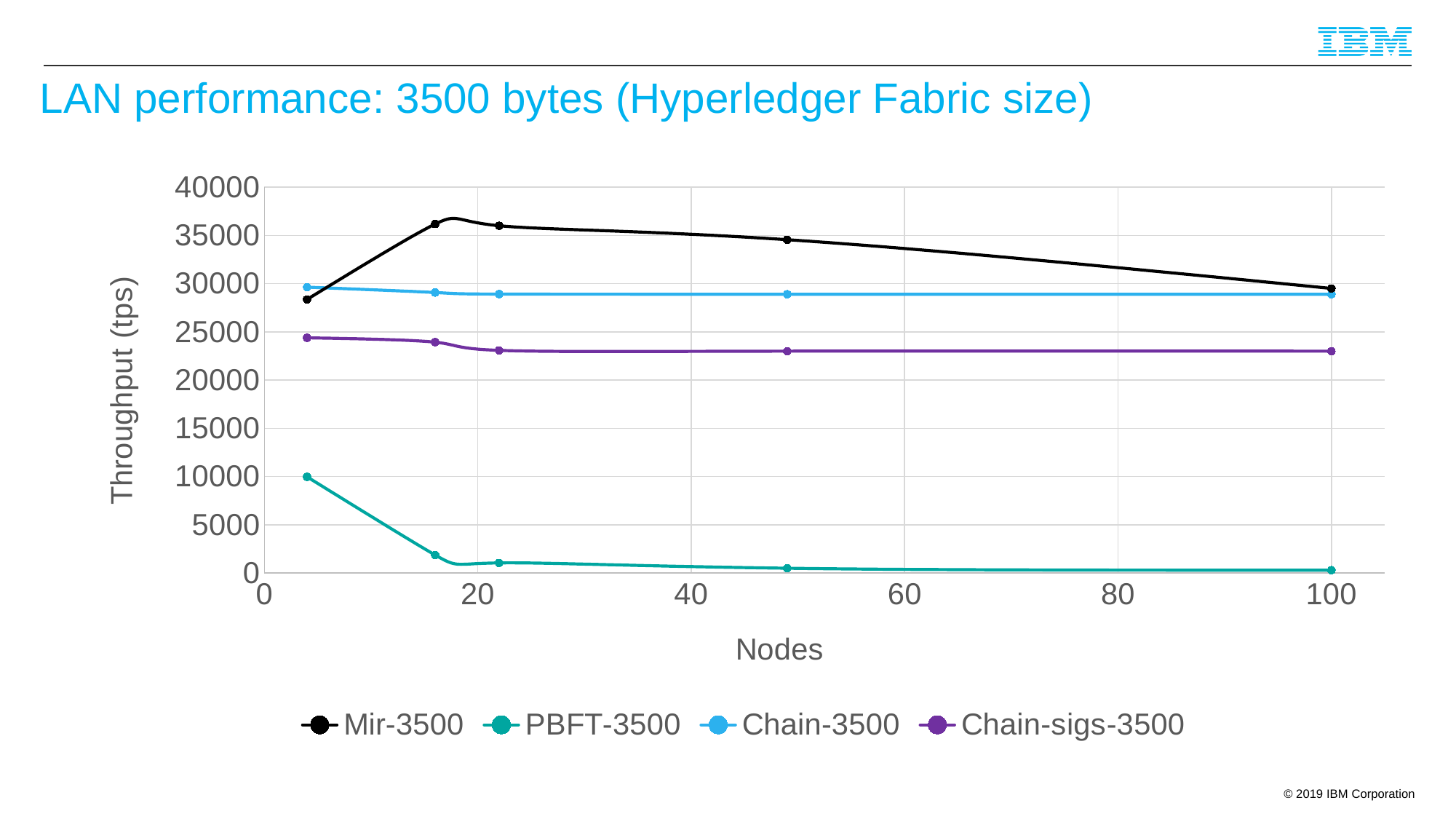
Is the throughput for Mir-3500 at around 49 nodes greater or less than 30000 tps? greater Which series has the highest throughput at around 49 nodes? Mir-3500 Which series has the lowest throughput across all node counts? PBFT-3500 Does the throughput of PBFT-3500 rise or fall as the number of nodes increases? fall Is the throughput for Chain-sigs-3500 at 100 nodes greater or less than 25000 tps? less At 100 nodes, which has higher throughput: Chain-3500 or Chain-sigs-3500? Chain-3500 How many data points are plotted for the Mir-3500 series? 5 At around 49 nodes, which has higher throughput: Mir-3500 or Chain-3500? Mir-3500 What kind of chart is shown on the slide? line chart What is the label of the y axis? Throughput (tps) Is the throughput for PBFT-3500 at 100 nodes greater or less than 5000 tps? less How many series does the legend list? 4